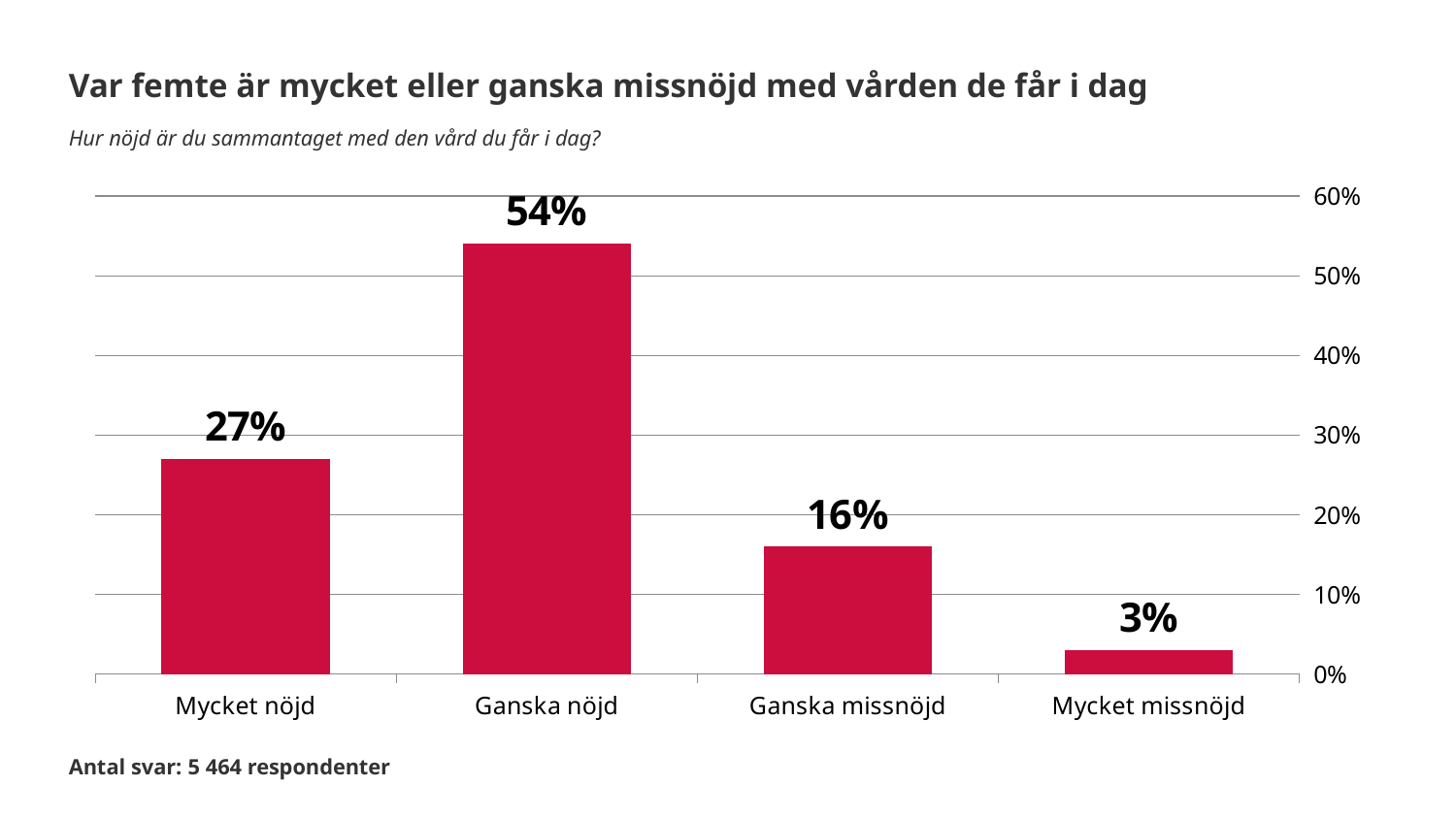
Which category has the lowest value? Mycket missnöjd What is the value for Ganska nöjd? 54% What is the survey question shown in italics below the chart title? Hur nöjd är du sammantaget med den vård du får i dag? Which is larger, the value for Mycket nöjd or the value for Ganska missnöjd? Mycket nöjd What is the difference between the values for Ganska nöjd and Mycket nöjd? 27% What is the value for Mycket nöjd? 27% What is the value for Mycket missnöjd? 3% Which category has the highest value? Ganska nöjd What kind of chart is shown on the slide? Bar chart How many categories are shown on the x axis? 4 What is the difference between the values for Ganska missnöjd and Mycket missnöjd? 13% What is the value for Ganska missnöjd? 16%